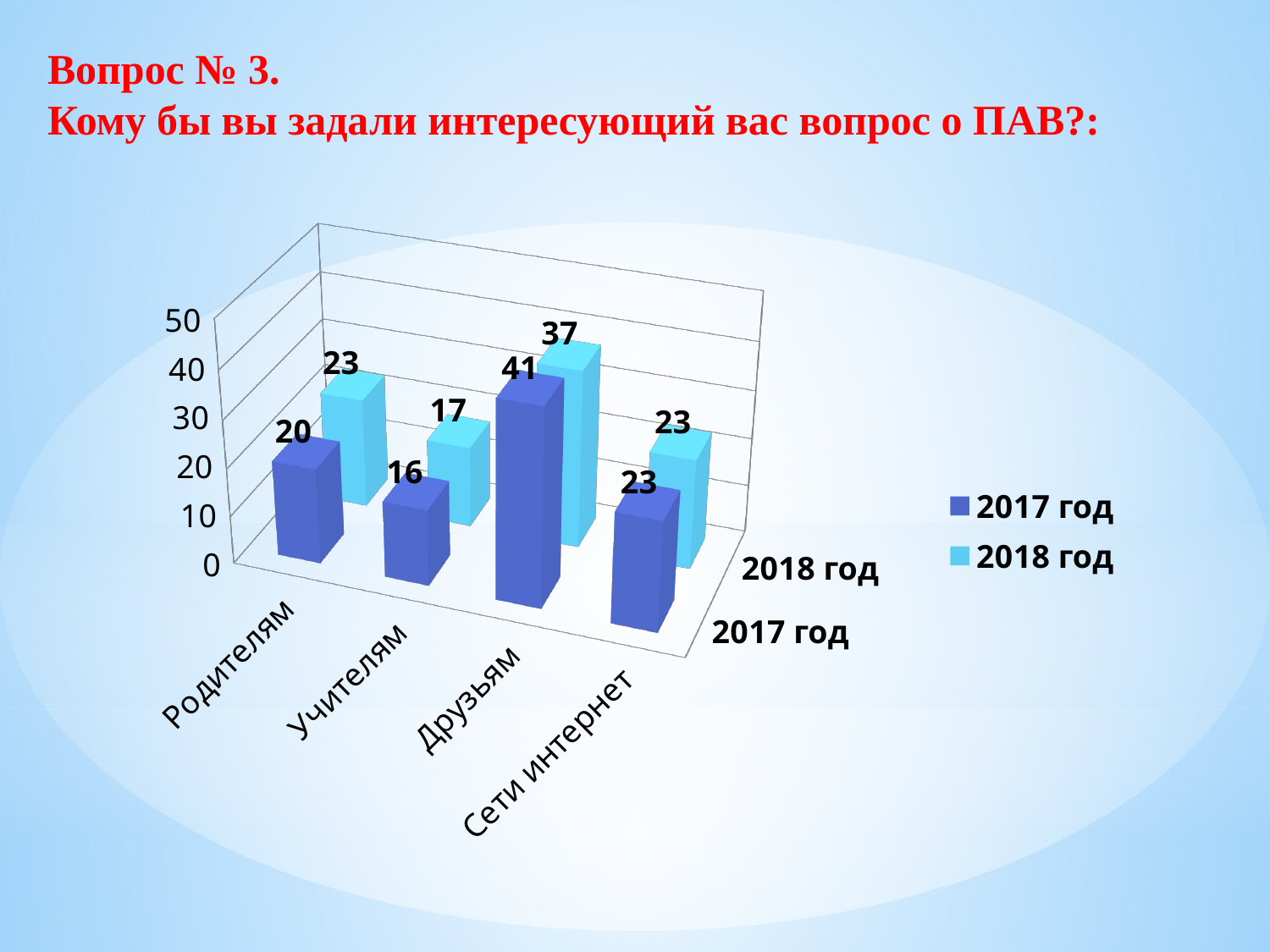
What is the value for Учителям in the 2017 год series? 16 What is the value for Родителям in the 2017 год series? 20 Which category has the highest value in the 2017 год series? Друзьям What kind of chart is shown on the slide? bar chart How many categories are shown on the x axis? 4 Which series is shown in light blue in the legend? 2018 год How many series does the legend list? 2 What is the value for Сети интернет in the 2018 год series? 23 Which is larger for Родителям: the 2017 год value or the 2018 год value? 2018 год What is the value for Друзьям in the 2018 год series? 37 Which category has the lowest value in the 2018 год series? Учителям What is the difference between the 2017 год and 2018 год values for Друзьям? 4